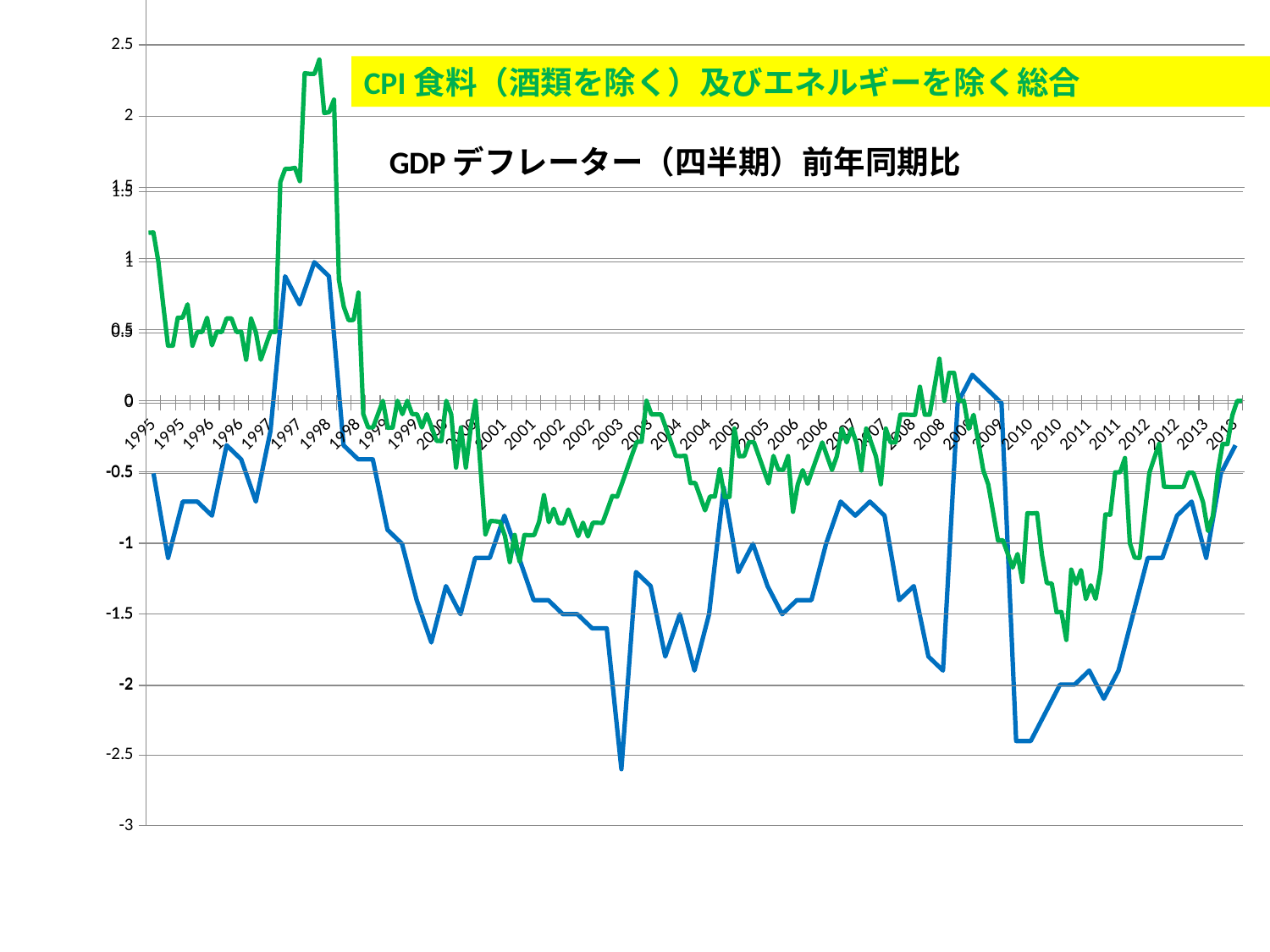
Is the peak value of the green CPI line around 1998 greater or less than 2? greater What kind of chart is shown on the slide? line chart Is the peak of the green CPI line around 2008 greater or less than 0? greater Which series is drawn with the green line? CPI 食料（酒類を除く）及びエネルギーを除く総合 Is the lowest value of the blue GDP deflator line, around 2003, greater or less than -2.5? less Which series is drawn with the blue line? GDP デフレーター（四半期）前年同期比 From its 1998 peak to 1999, does the green CPI line rise or fall? fall How many data series are plotted on the chart? 2 From 2010 to 2013, does the blue GDP deflator line generally rise or fall? rise Which series reaches the higher peak around 1998, the CPI series or the GDP deflator series? CPI series Around 2003, which line is higher, the green CPI line or the blue GDP deflator line? green CPI line